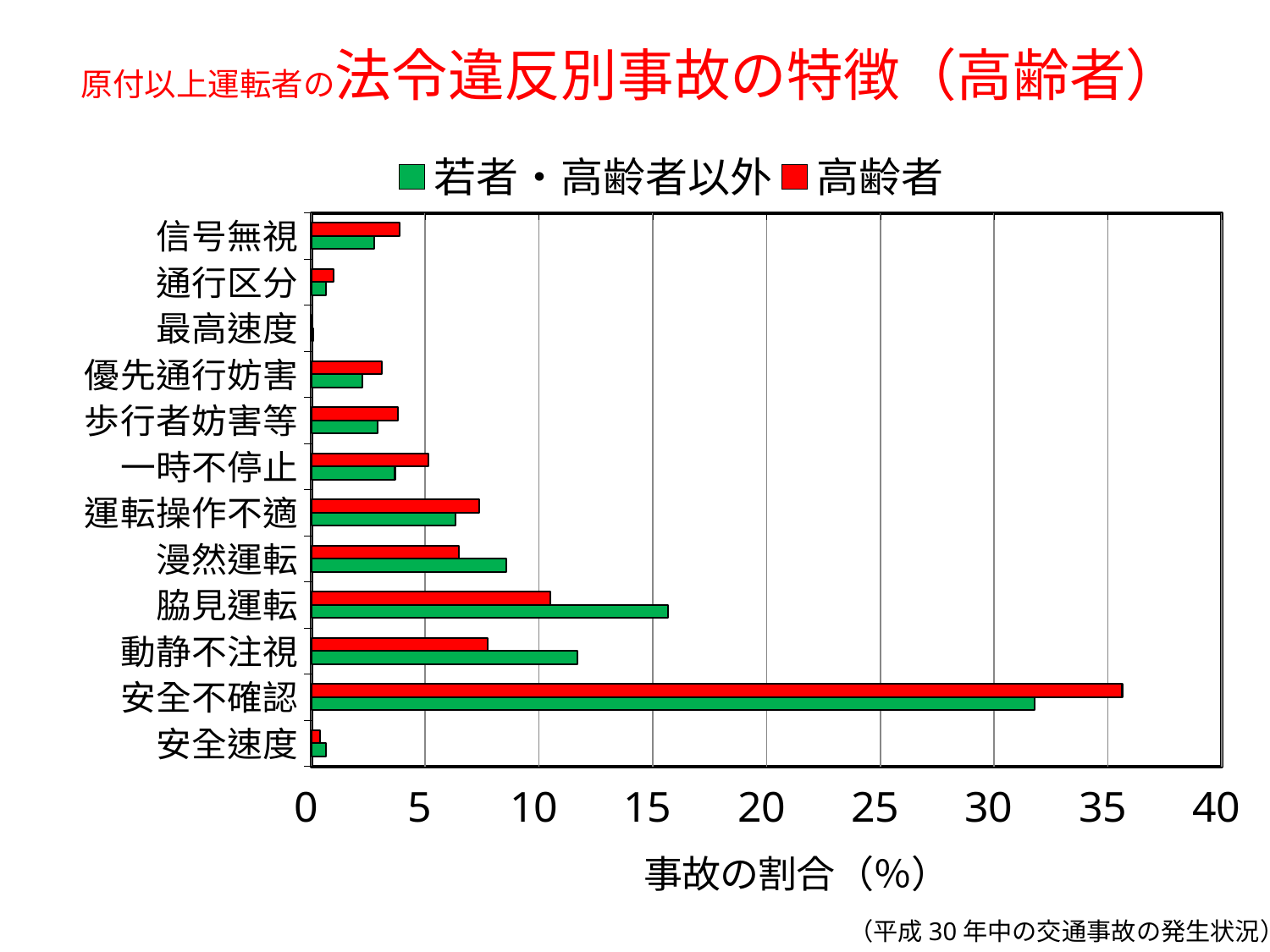
Is the value for 安全不確認 in the 高齢者 series greater or less than 30? greater How many series does the legend list? 2 Which category has the highest value for 高齢者? 安全不確認 Is the value for 脇見運転 in the 高齢者 series greater or less than 15? less Which category has the highest value for 若者・高齢者以外? 安全不確認 Is the value for 動静不注視 in the 若者・高齢者以外 series greater or less than 10? greater For 脇見運転, which series has the larger value, 若者・高齢者以外 or 高齢者? 若者・高齢者以外 What kind of chart is shown on the slide? bar chart Which category has the lowest value for 高齢者? 最高速度 What is the title of the x axis? 事故の割合（%） For 安全不確認, which series has the larger value, 若者・高齢者以外 or 高齢者? 高齢者 How many violation categories are plotted on the y axis? 12